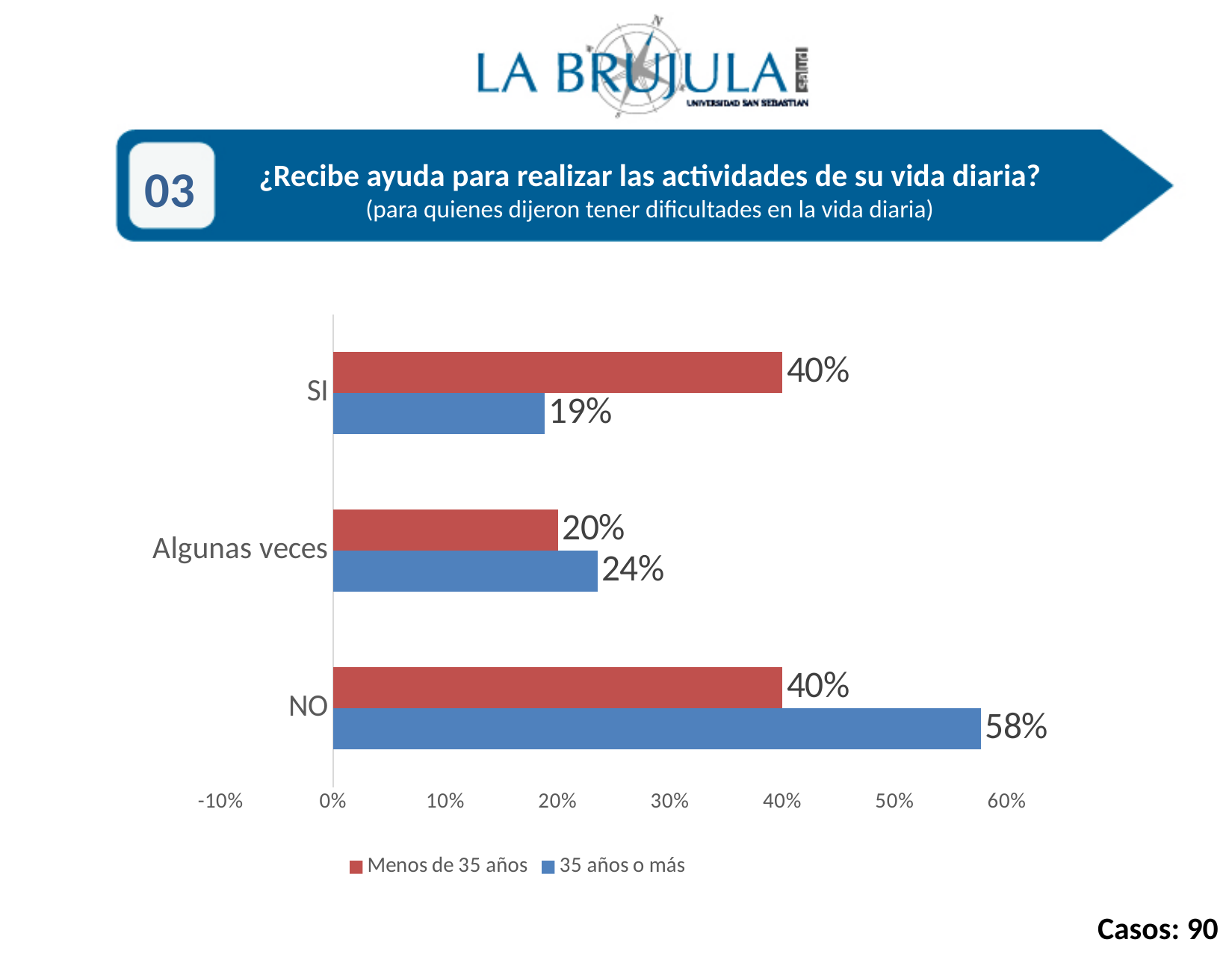
What is the value for "Menos de 35 años" in the "Algunas veces" category? 20% How many categories are shown on the chart? 3 What is the value for "35 años o más" in the NO category? 58% What is the value for "35 años o más" in the "Algunas veces" category? 24% In the SI category, which series has the larger value, "Menos de 35 años" or "35 años o más"? Menos de 35 años Which category has the lowest value for the "35 años o más" series? SI How many series does the legend list? 2 What is the difference between the "35 años o más" and "Menos de 35 años" values in the NO category? 18% What kind of chart is shown on the slide? Bar chart What is the value for "Menos de 35 años" in the SI category? 40% Which category has the lowest value for the "Menos de 35 años" series? Algunas veces Which category has the highest value for the "35 años o más" series? NO